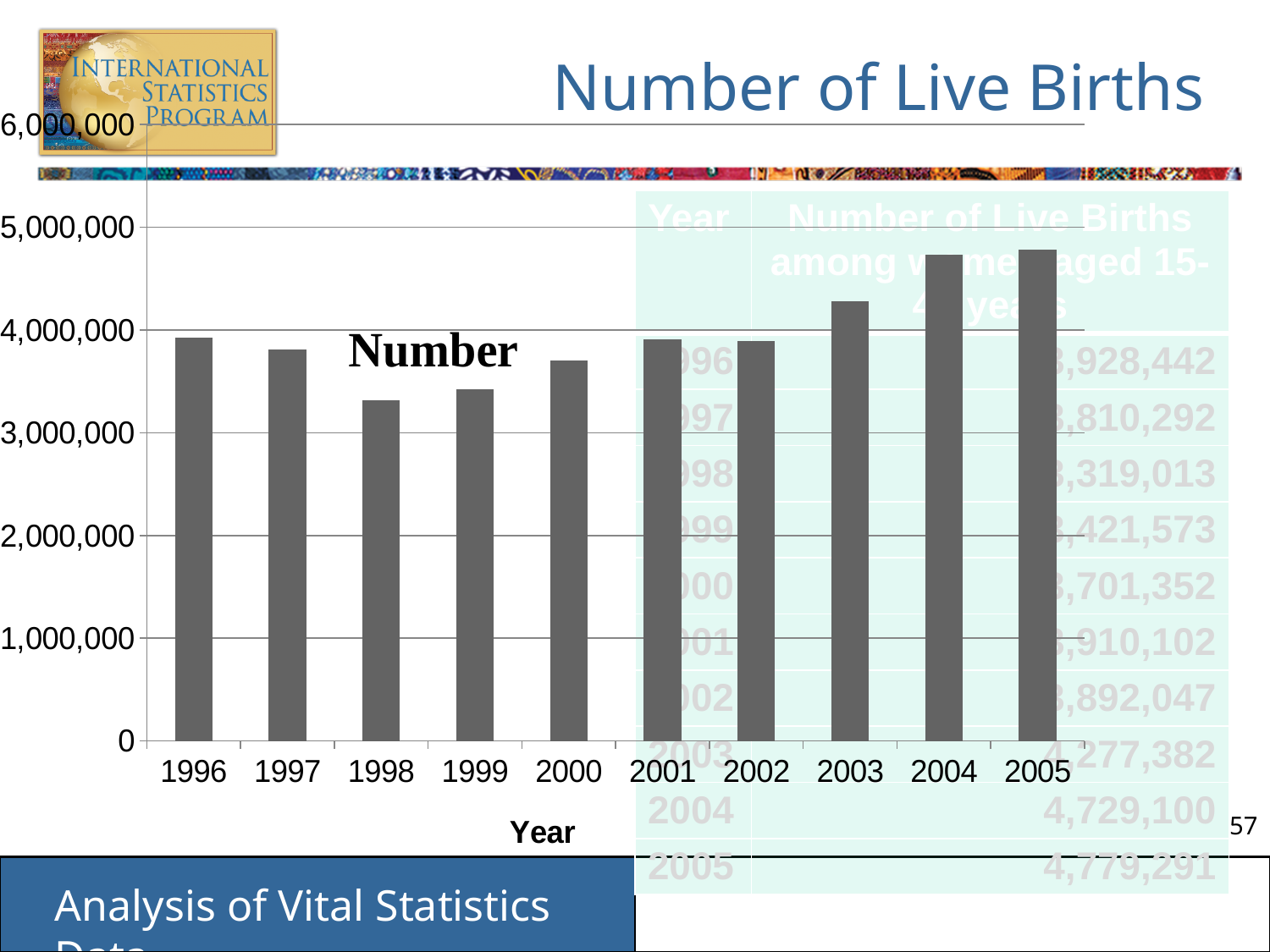
How many years are shown on the x axis of the chart? 10 Is the value for 1996 greater or less than 3,000,000? greater Is the value for 2000 greater or less than 4,000,000? less Is the value for 2005 greater or less than 5,000,000? less What kind of chart is shown on the slide? bar chart Which year has the lowest number of live births in the chart? 1998 Which year has the larger value, 2000 or 2003? 2003 Which year has the larger value, 1997 or 1998? 1997 From 2002 to 2005, do the values rise or fall? rise What is the title of the x axis of the chart? Year